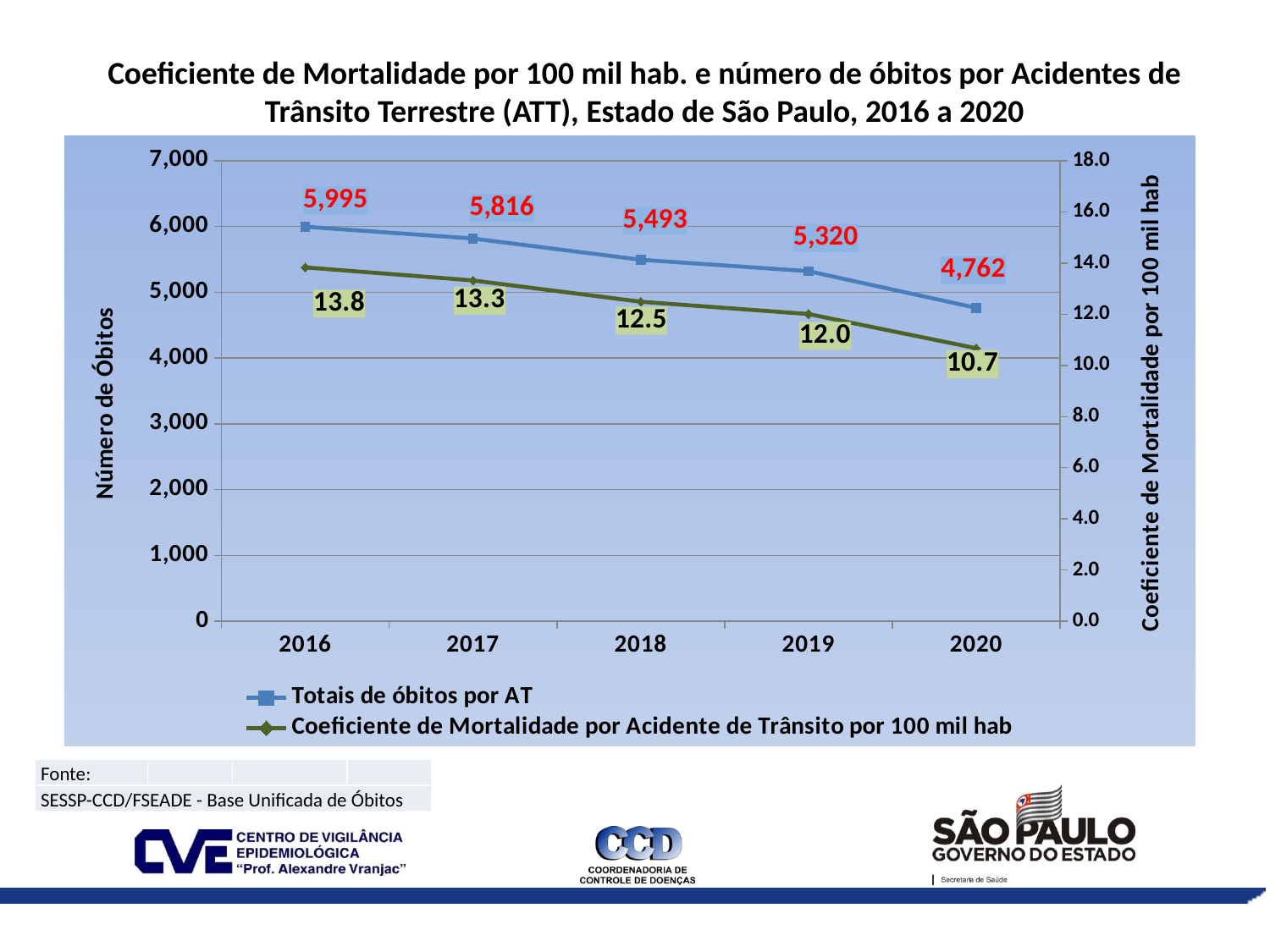
In which year is the 'Coeficiente de Mortalidade por Acidente de Trânsito por 100 mil hab' lowest? 2020 What is the 'Coeficiente de Mortalidade por Acidente de Trânsito por 100 mil hab' in 2020? 10.7 What is the value of 'Totais de óbitos por AT' in 2019? 5,320 What is the value of 'Totais de óbitos por AT' in 2016? 5,995 What is the difference in 'Totais de óbitos por AT' between 2016 and 2020? 1,233 How many years are shown on the x axis? 5 How many series does the legend list? 2 What kind of chart is shown on the slide? Line chart In which year is 'Totais de óbitos por AT' highest? 2016 Which year has a larger 'Totais de óbitos por AT', 2017 or 2018? 2017 Do the values of 'Totais de óbitos por AT' rise or fall from 2016 to 2020? Fall What is the difference in the mortality coefficient between 2017 and 2018? 0.8